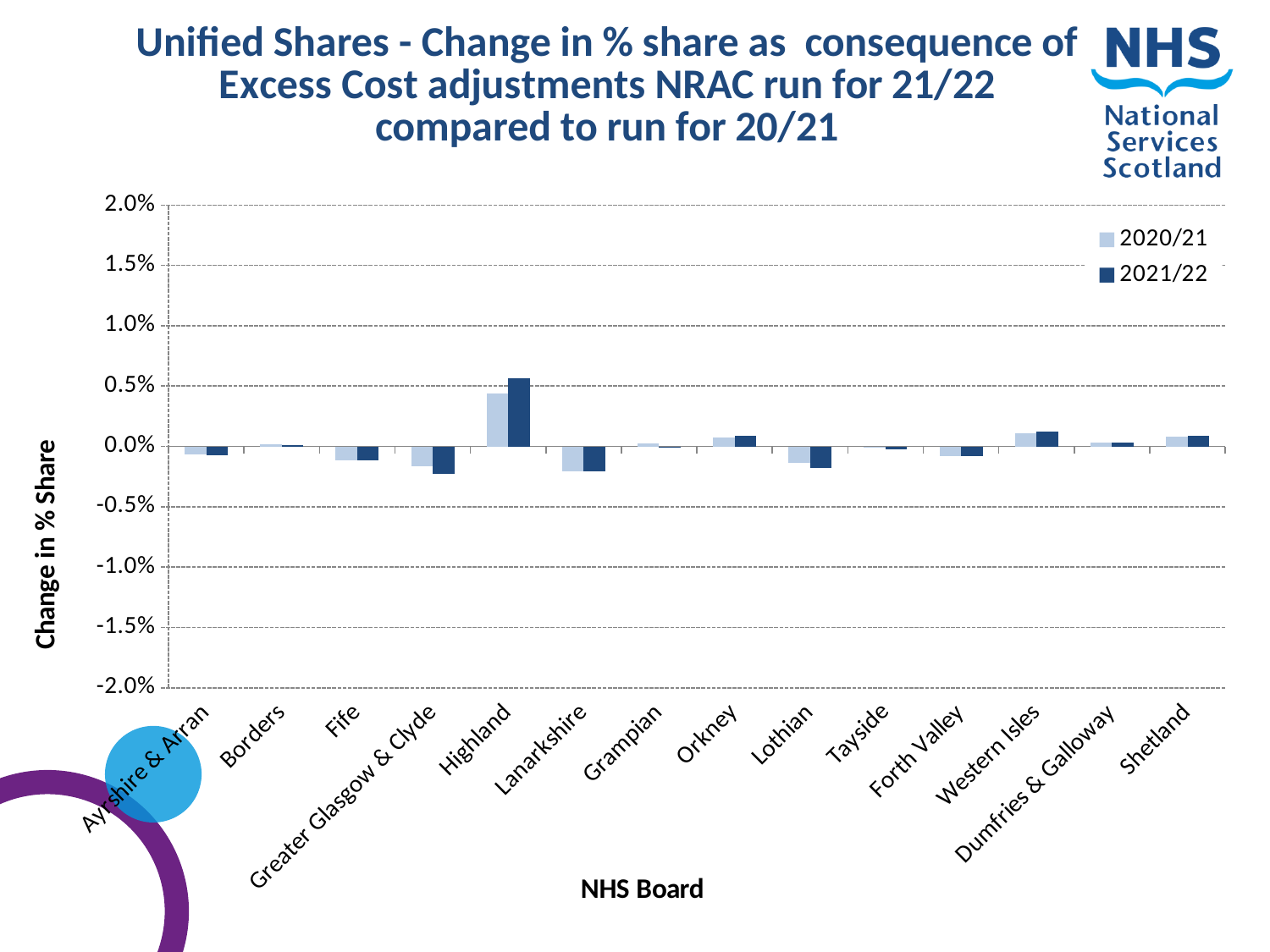
For Highland, which series has the larger value, 2020/21 or 2021/22? 2021/22 Which has the larger 2021/22 value, Orkney or Lothian? Orkney Is the 2020/21 value for Highland greater or less than 0.5%? less What is the label on the x axis? NHS Board What is the label on the y axis? Change in % Share How many series does the legend list? 2 Which NHS Board has the highest change in % share for 2021/22? Highland Is the 2021/22 value for Greater Glasgow & Clyde greater or less than 0.0%? less Is the 2021/22 value for Lanarkshire greater or less than -0.5%? greater What kind of chart is shown on the slide? bar chart Which NHS Board has the highest change in % share for 2020/21? Highland How many NHS Boards are shown on the x axis? 14